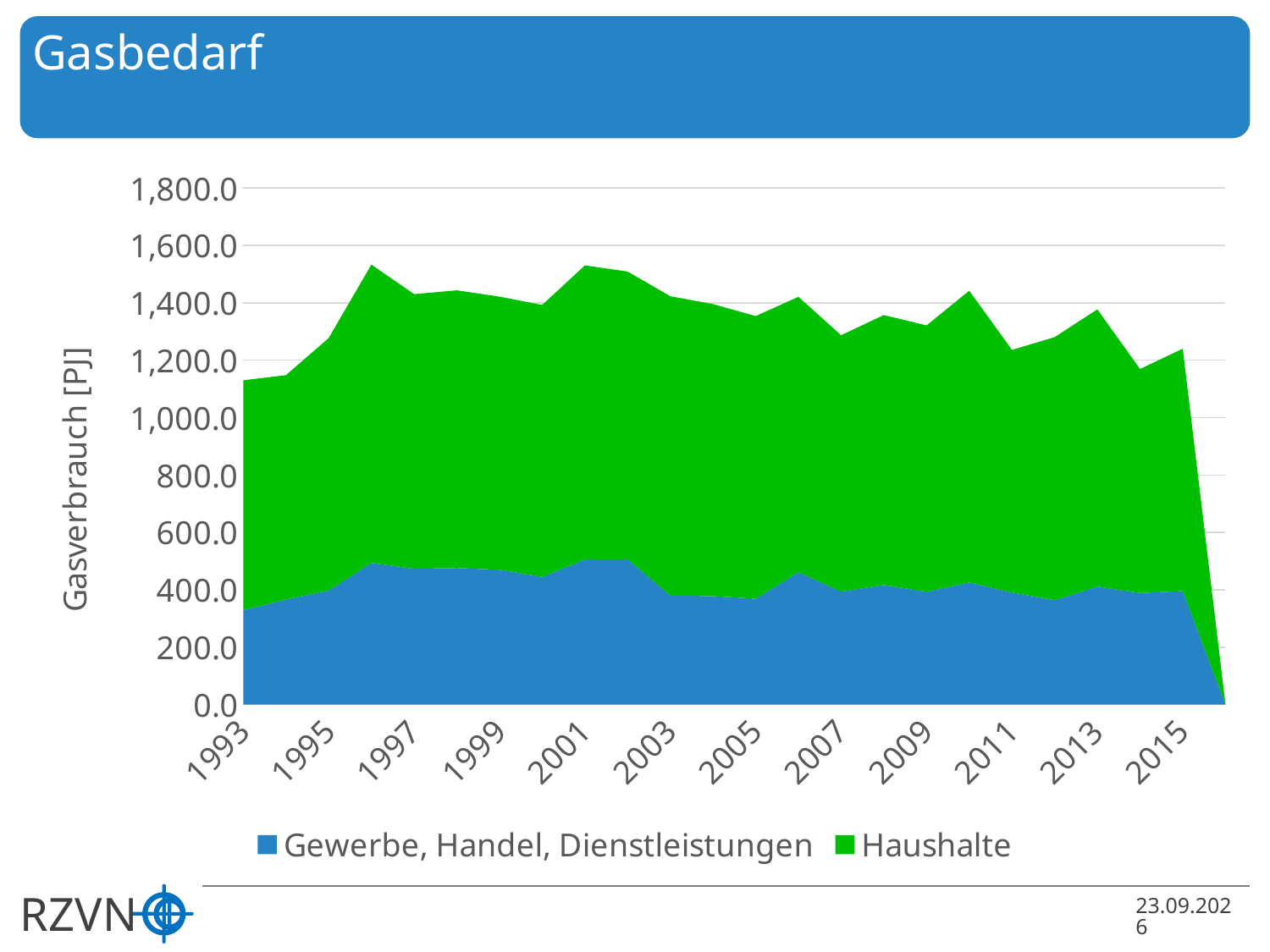
Is the value for Gewerbe, Handel, Dienstleistungen in 1993 greater or less than 400? less What kind of chart is shown on the slide? stacked area chart Is the value for Gewerbe, Handel, Dienstleistungen in 1997 greater or less than 400? greater Which two series are listed in the legend? Gewerbe, Handel, Dienstleistungen; Haushalte Does the total gas consumption rise or fall from 1993 to 1996? rise Is the total gas consumption (both series combined) in 1996 greater or less than 1,400? greater How many series does the legend list? 2 What is the label of the vertical axis? Gasverbrauch [PJ] How many year labels are shown on the x axis? 12 Which year has the larger total gas consumption, 1993 or 1996? 1996